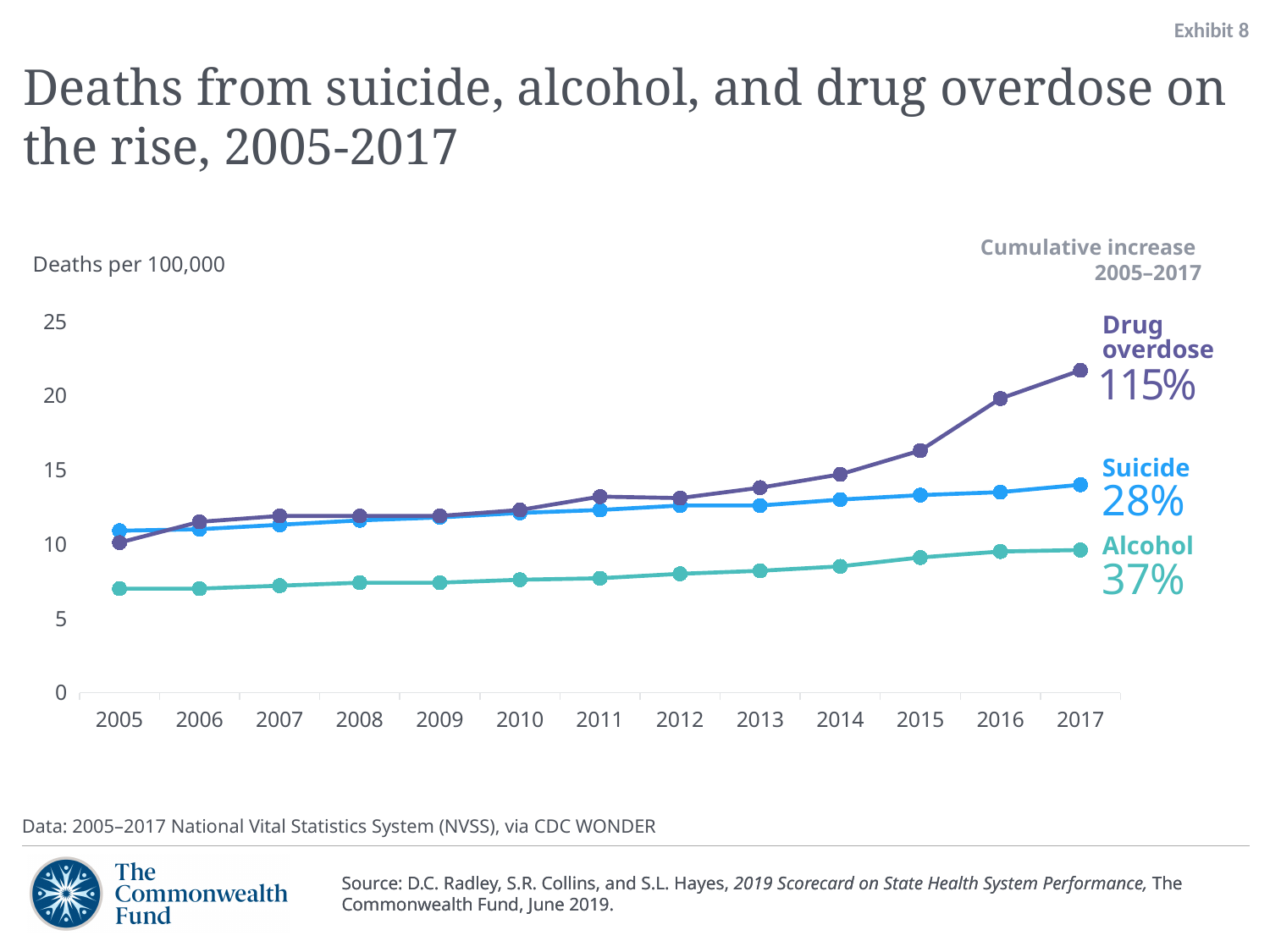
How many years are shown along the x axis? 13 Which series has the highest death rate in 2017? Drug overdose Which series has the lowest death rate in 2017? Alcohol Does the drug overdose death rate rise or fall from 2005 to 2017? rise How many series are plotted on the chart? 3 What is the cumulative increase from 2005 to 2017 for drug overdose deaths? 115% What is the cumulative increase from 2005 to 2017 for suicide deaths? 28% Is the alcohol death rate in 2005 greater or less than 10? less What is the unit shown for the y axis? Deaths per 100,000 What kind of chart is shown on the slide? line chart Is the drug overdose death rate in 2017 greater or less than 20? greater What is the cumulative increase from 2005 to 2017 for alcohol deaths? 37%